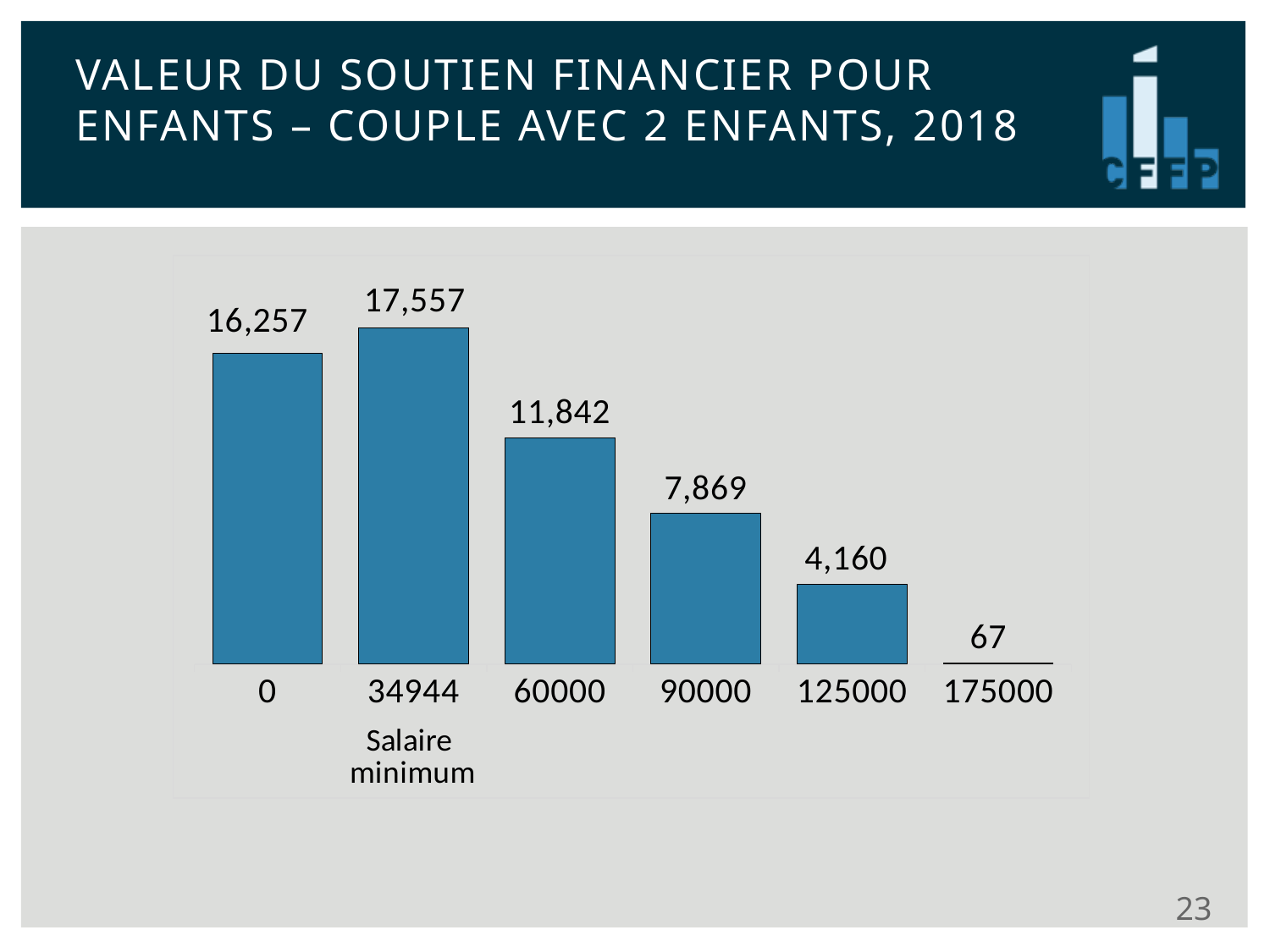
Which income level has the highest value of financial support for children? 34944 How many income levels are shown on the chart? 6 What is the value of financial support for children at an income of 60000? 11,842 What kind of chart is shown on the slide? Bar chart What is the value of financial support for children at an income of 0? 16,257 Which income level on the x axis is labelled 'Salaire minimum'? 34944 Which is larger: the value at 0 or the value at 60000? 0 From 34944 onwards, do the values rise or fall as income increases? Fall What is the value of financial support for children at an income of 175000? 67 Which income level has the lowest value of financial support for children? 175000 What is the value of financial support for children at an income of 34944 (Salaire minimum)? 17,557 What is the difference between the value at 90000 and the value at 125000? 3,709